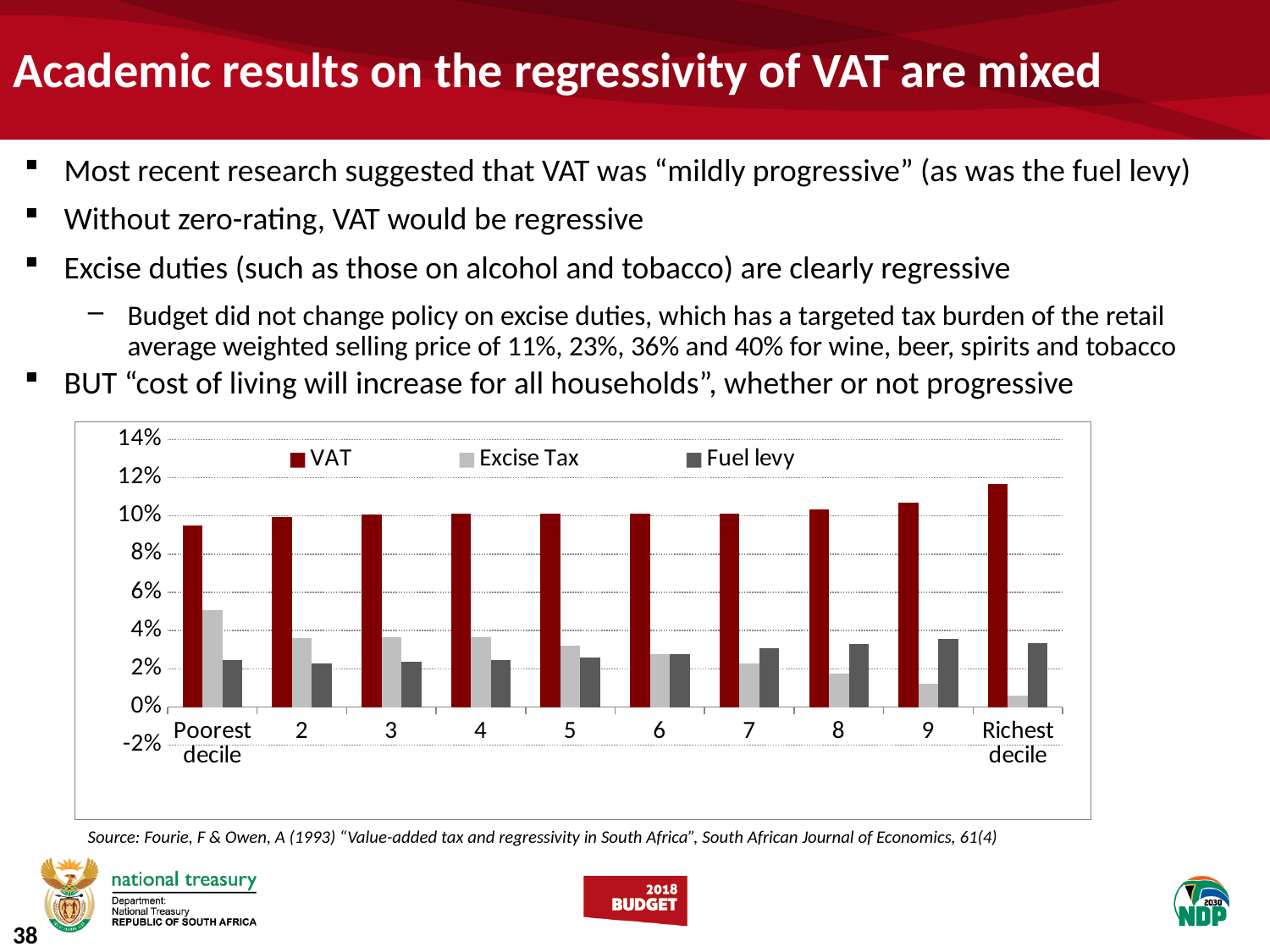
Is the Excise Tax value for the Richest decile greater or less than 2%? less How many decile categories are shown along the x axis of the chart? 10 For the Poorest decile, which is larger: Excise Tax or Fuel levy? Excise Tax Is the VAT value for the Poorest decile greater or less than 8%? greater Is the Excise Tax value for the Poorest decile greater or less than 4%? greater Which decile has the highest Excise Tax value in the chart? Poorest decile Which decile has the lowest Excise Tax value in the chart? Richest decile For the Richest decile, which is larger: Excise Tax or Fuel levy? Fuel levy Does the Excise Tax series rise or fall moving from the Poorest decile to the Richest decile? Fall How many series does the chart legend list? 3 Which decile has the highest VAT value in the chart? Richest decile What kind of chart is shown on the slide? Bar chart